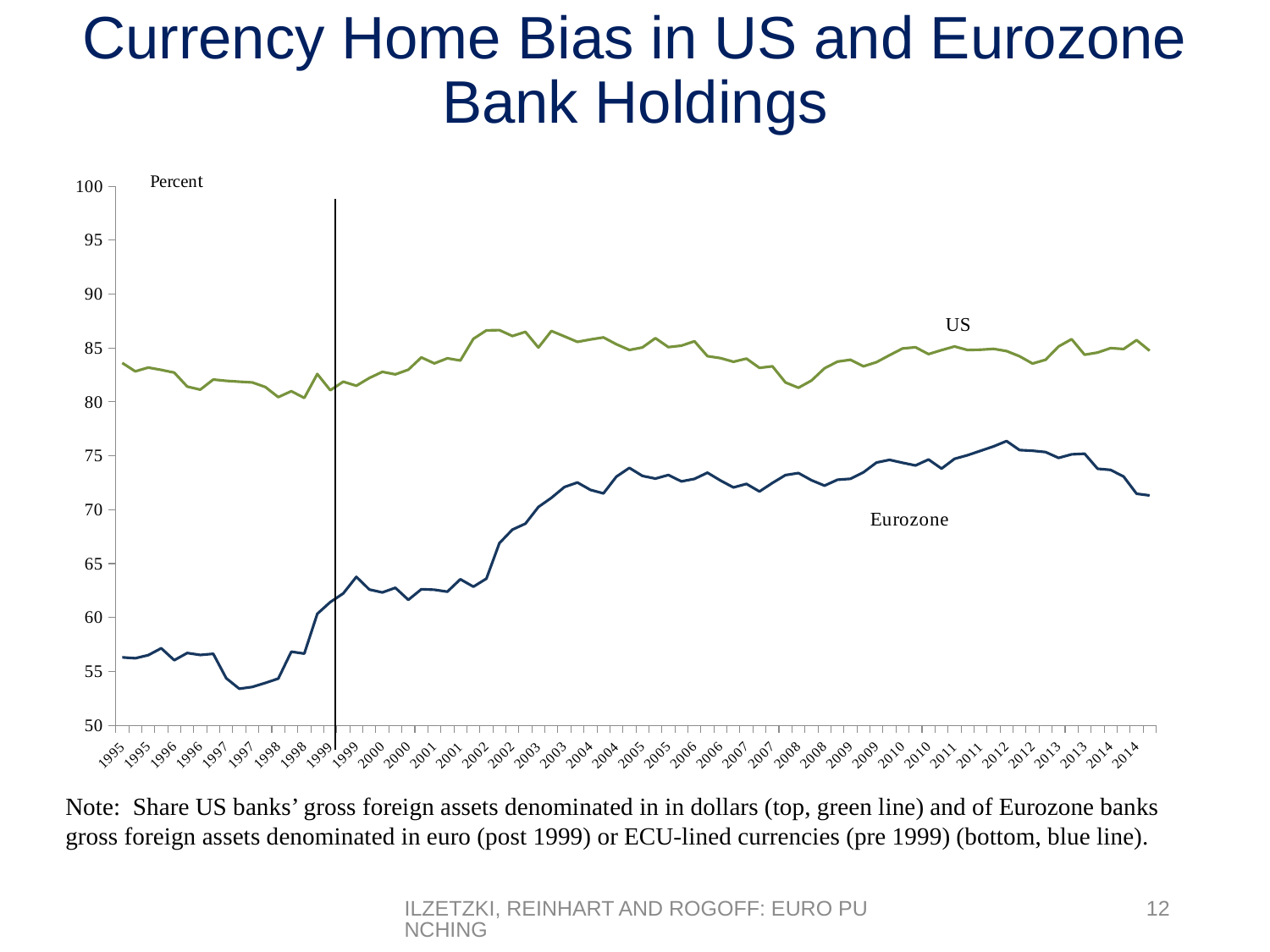
What unit is shown on the vertical axis of the chart? Percent Is the value for the US line in 2002 greater or less than 85? greater Is the value for the Eurozone line in 2000 greater or less than 60? greater Does the Eurozone line overall rise or fall between 1995 and 2012? rise Is the value for the US line in 2008 greater or less than 85? less What kind of chart is shown on the slide? line chart How many series (lines) are plotted on the chart? 2 What colour is the US line on the chart? green Which series has the higher values throughout the chart, US or Eurozone? US